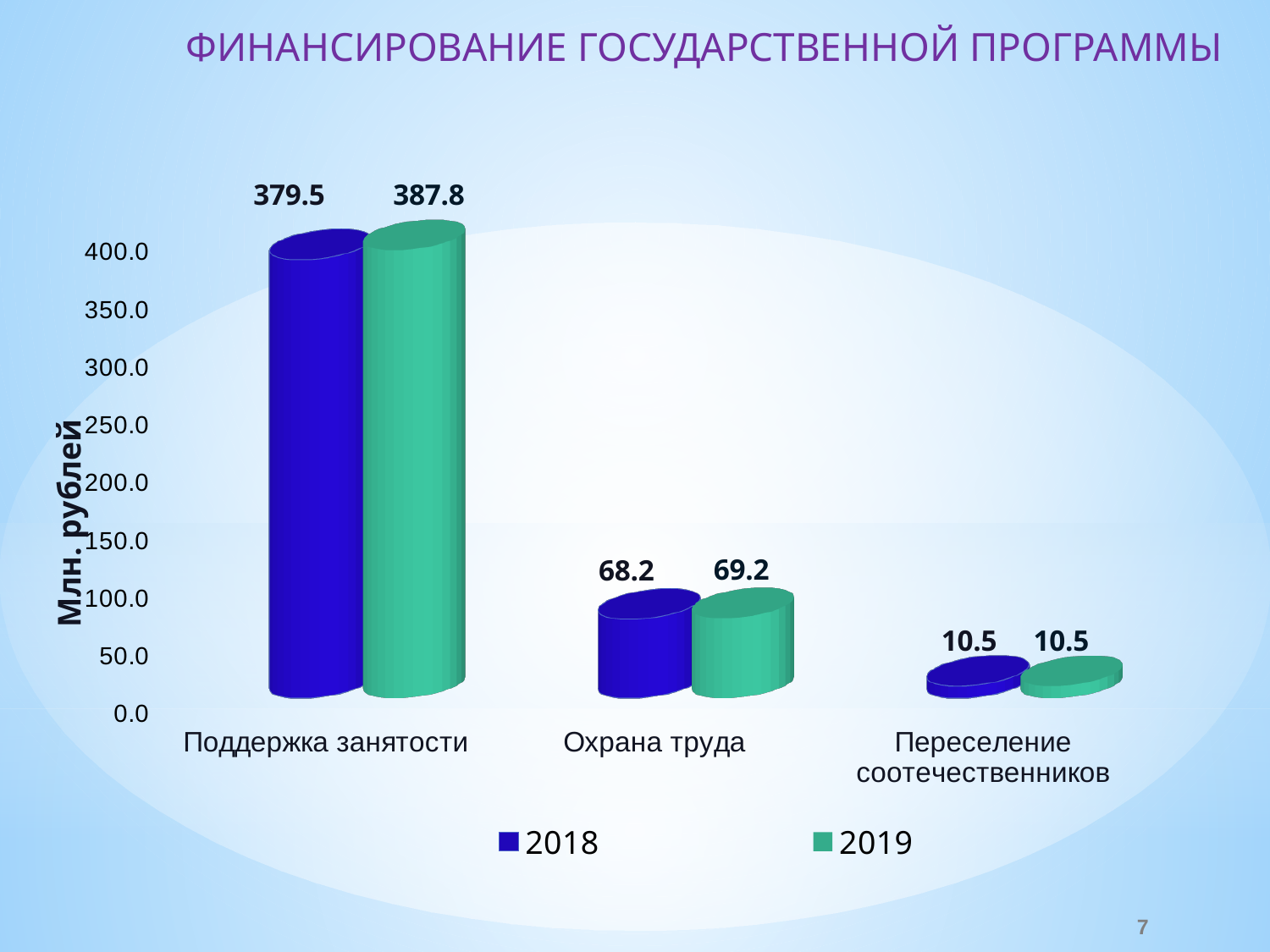
Is the 2018 value for Охрана труда greater or less than 100.0? less What is the difference between the 2019 and 2018 values for Охрана труда? 1.0 What is the 2019 value for Охрана труда? 69.2 What is the 2019 value for Переселение соотечественников? 10.5 How many series does the legend list? 2 Which is larger for Поддержка занятости, the 2018 value or the 2019 value? 2019 What is the 2018 value for Поддержка занятости? 379.5 Which category has the highest 2019 value? Поддержка занятости Which category has the lowest 2018 value? Переселение соотечественников How many categories are shown on the x axis? 3 What kind of chart is shown on the slide? bar chart What is the difference between the 2019 and 2018 values for Поддержка занятости? 8.3